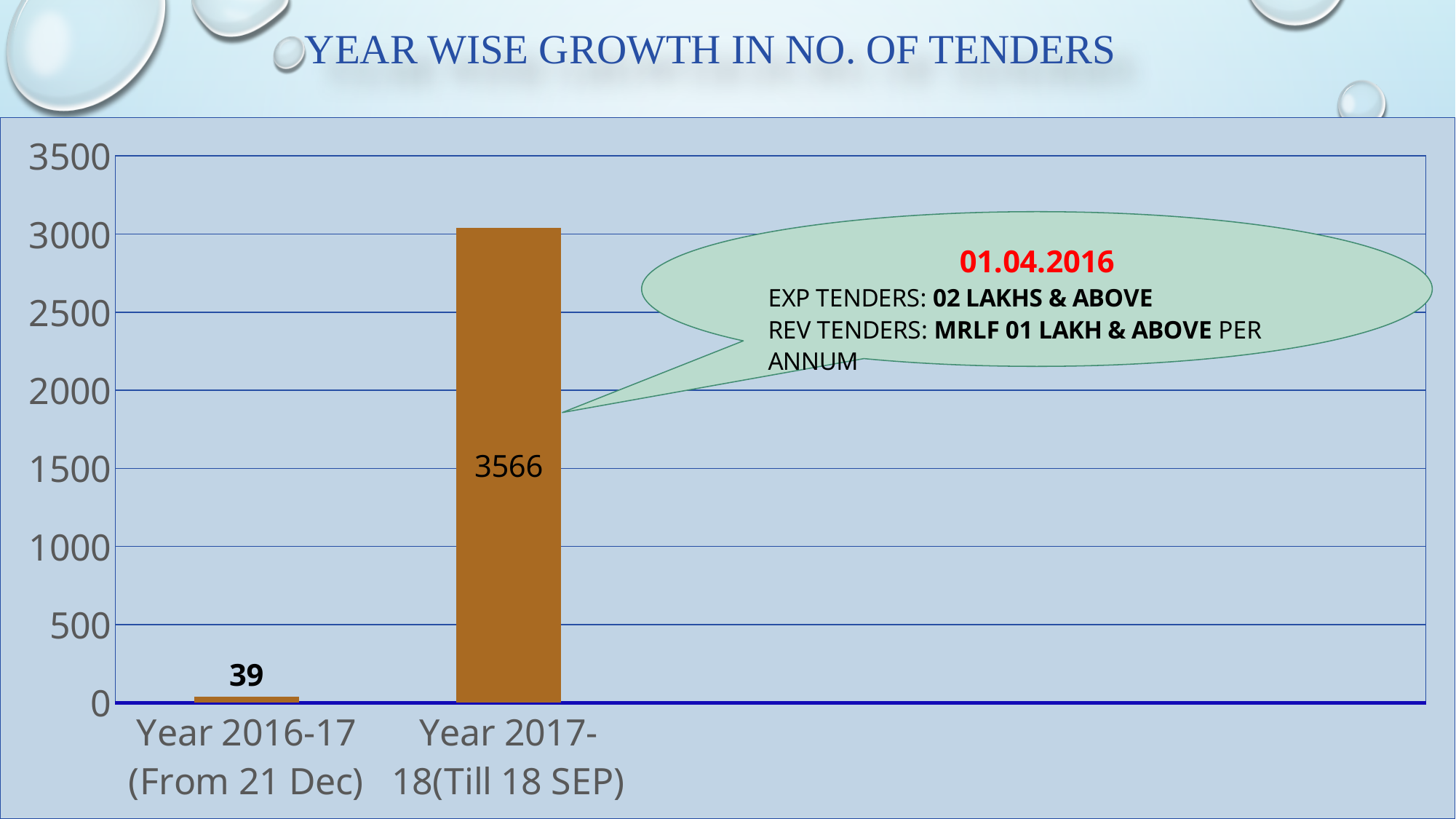
Which is larger, the number of tenders in Year 2016-17 (From 21 Dec) or in Year 2017-18 (Till 18 SEP)? Year 2017-18 (Till 18 SEP) What is the number of tenders for Year 2017-18 (Till 18 SEP)? 3566 Which year has the highest number of tenders? Year 2017-18 (Till 18 SEP) Is the value for Year 2016-17 (From 21 Dec) greater or less than 500? less What is the number of tenders for Year 2016-17 (From 21 Dec)? 39 What is the title of the chart on the slide? YEAR WISE GROWTH IN NO. OF TENDERS Do the values rise or fall from Year 2016-17 to Year 2017-18? Rise How many categories (years) are shown on the chart? 2 What is the difference in the number of tenders between Year 2017-18 (Till 18 SEP) and Year 2016-17 (From 21 Dec)? 3527 What kind of chart is shown on the slide? Bar chart Is the value for Year 2017-18 (Till 18 SEP) greater or less than 2500? greater Which year has the lowest number of tenders? Year 2016-17 (From 21 Dec)